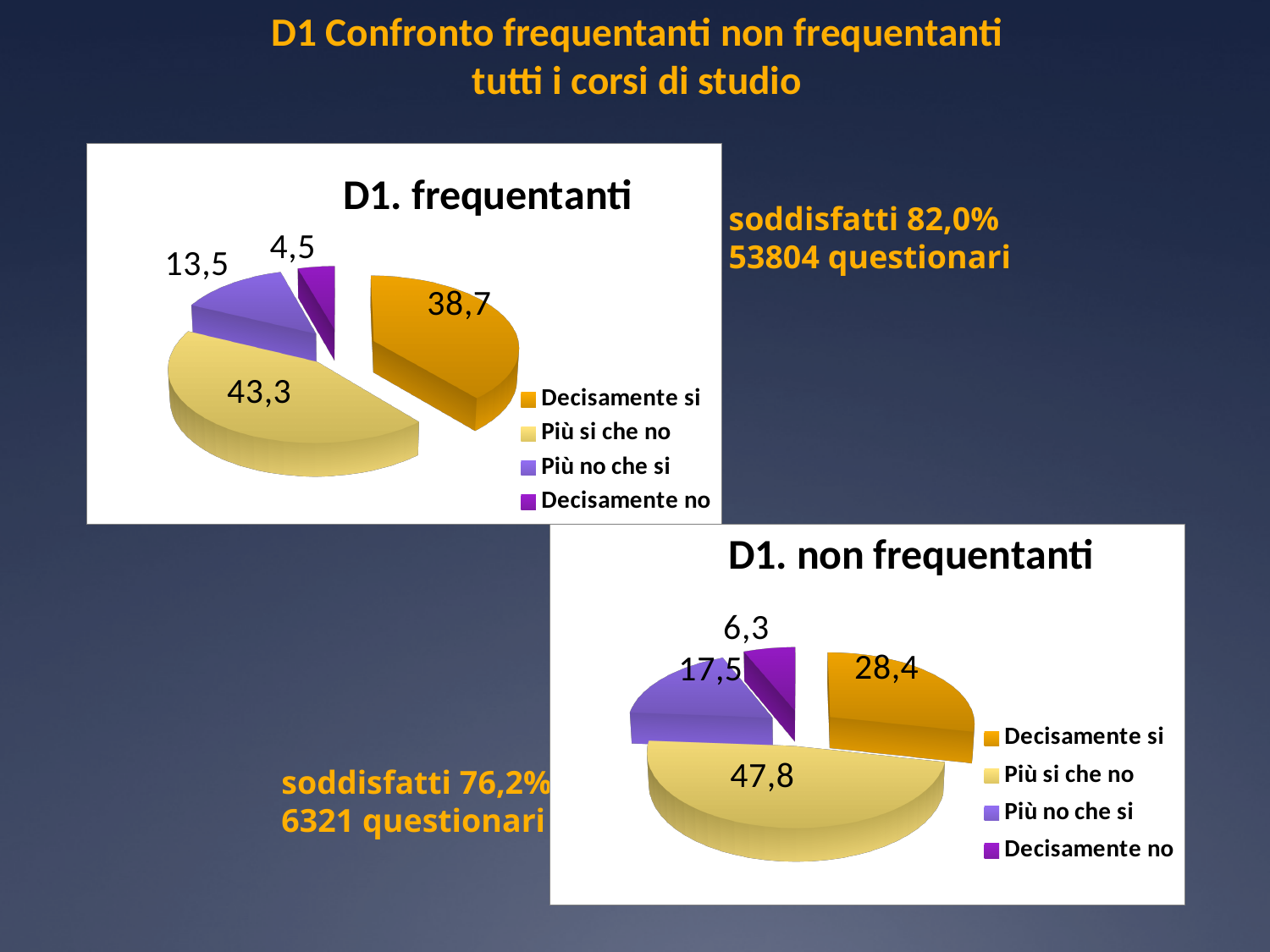
In the 'D1. frequentanti' chart, which category has the largest slice? Più si che no In the 'D1. non frequentanti' chart, what is the difference between 'Più no che si' and 'Decisamente no'? 11,2 In the 'D1. non frequentanti' chart, what is the value for 'Decisamente si'? 28,4 Which is larger: 'Decisamente si' in the 'D1. frequentanti' chart or 'Decisamente si' in the 'D1. non frequentanti' chart? D1. frequentanti In the 'D1. non frequentanti' chart, which category has the smallest slice? Decisamente no In the 'D1. frequentanti' chart, what is the value for 'Decisamente no'? 4,5 In the 'D1. frequentanti' chart, what is the difference between 'Più si che no' and 'Decisamente si'? 4,6 In the 'D1. frequentanti' chart, what is the value for 'Più si che no'? 43,3 In the 'D1. non frequentanti' chart, what is the value for 'Più no che si'? 17,5 What type of chart is 'D1. frequentanti'? Pie chart How many slices does the 'D1. non frequentanti' pie chart have? 4 In the 'D1. frequentanti' chart, which colour represents 'Più no che si'? Purple